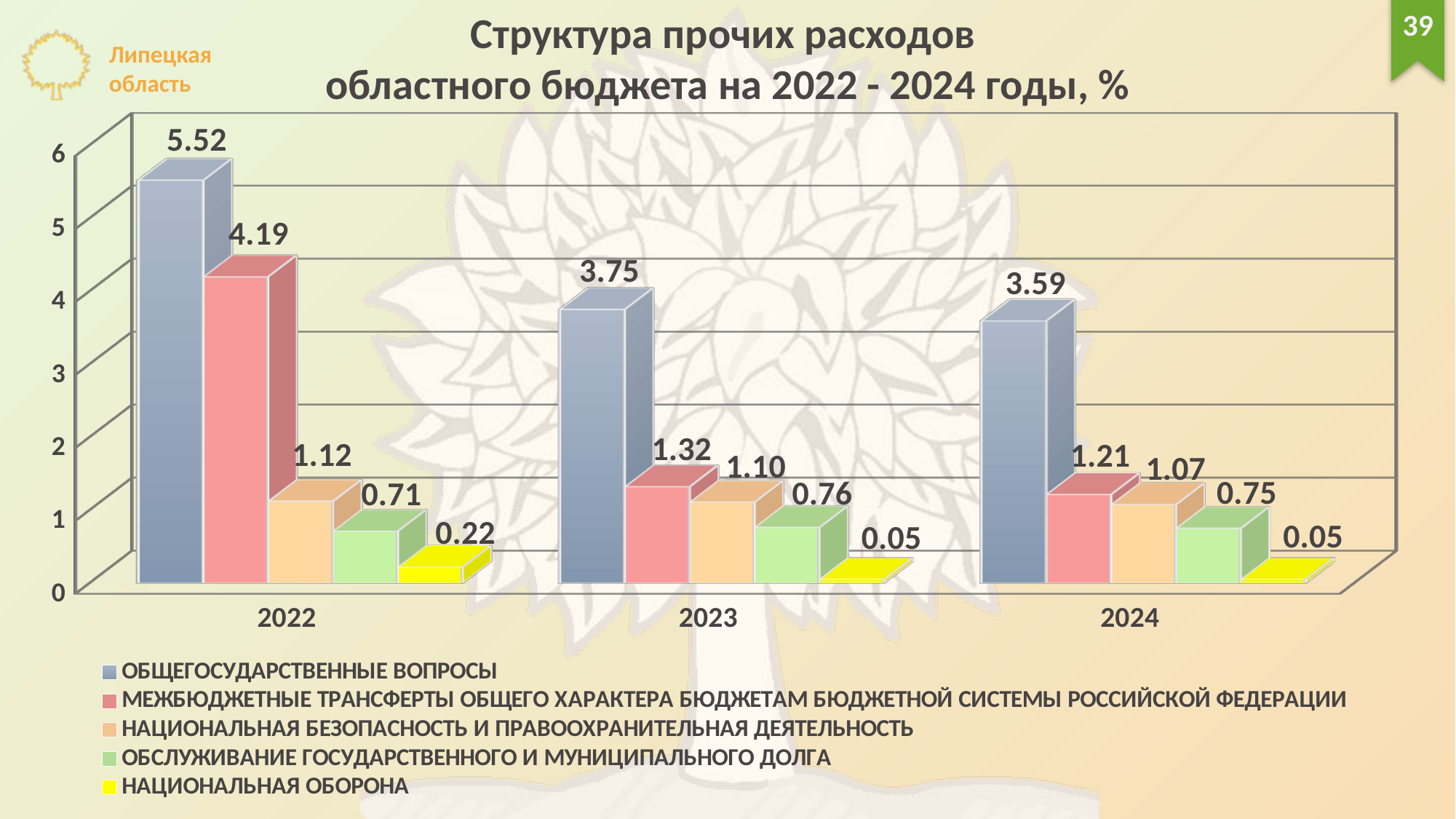
What is the value for ОБСЛУЖИВАНИЕ ГОСУДАРСТВЕННОГО И МУНИЦИПАЛЬНОГО ДОЛГА in 2023? 0.76 What kind of chart is shown on the slide? Bar chart What is the value for НАЦИОНАЛЬНАЯ ОБОРОНА in 2024? 0.05 What is the value for МЕЖБЮДЖЕТНЫЕ ТРАНСФЕРТЫ ОБЩЕГО ХАРАКТЕРА БЮДЖЕТАМ БЮДЖЕТНОЙ СИСТЕМЫ РОССИЙСКОЙ ФЕДЕРАЦИИ in 2023? 1.32 Do the values for ОБЩЕГОСУДАРСТВЕННЫЕ ВОПРОСЫ rise or fall from 2022 to 2024? Fall What is the difference between the ОБЩЕГОСУДАРСТВЕННЫЕ ВОПРОСЫ values for 2022 and 2023? 1.77 Which series has the highest value in 2024? ОБЩЕГОСУДАРСТВЕННЫЕ ВОПРОСЫ How many series does the legend list? 5 Which is larger: НАЦИОНАЛЬНАЯ БЕЗОПАСНОСТЬ И ПРАВООХРАНИТЕЛЬНАЯ ДЕЯТЕЛЬНОСТЬ in 2022 or in 2024? 2022 What is the value for ОБЩЕГОСУДАРСТВЕННЫЕ ВОПРОСЫ in 2022? 5.52 How many years are shown on the x axis? 3 Which series has the lowest value in 2022? НАЦИОНАЛЬНАЯ ОБОРОНА